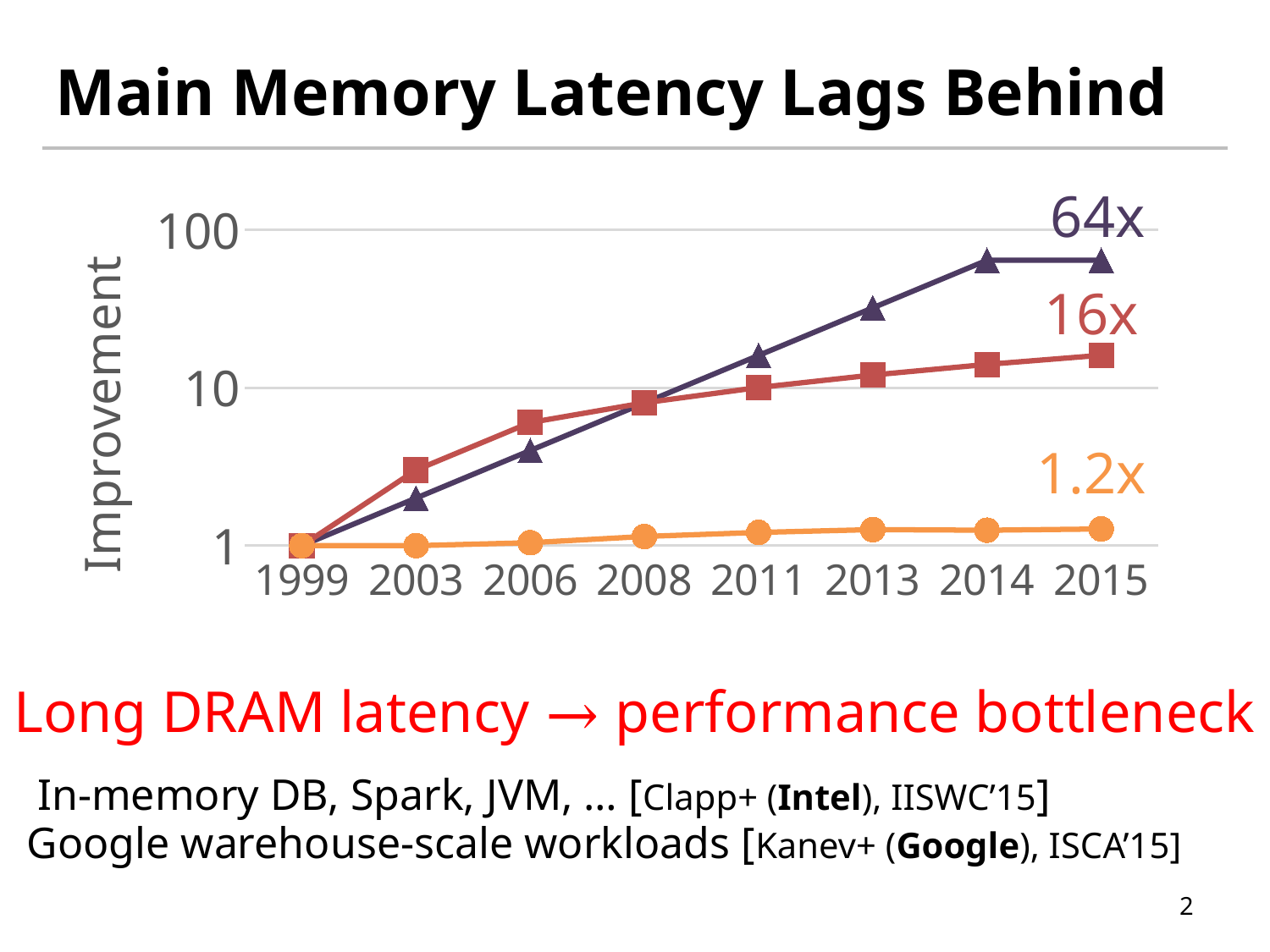
In 2015, which is larger: the improvement of the purple triangle line or the red square line? the purple triangle line What improvement value is labelled at the end of the orange line with circle markers? 1.2x How many years are marked along the x axis of the chart? 8 What is the title of the y axis of the chart? Improvement What kind of chart is shown on the slide? line chart Which line shows the lowest improvement by 2015? the orange line with circle markers (1.2x) Which line reaches the highest improvement by 2015? the purple line with triangle markers (64x) Is the value of the red square line in 2006 greater or less than 10? less What improvement value is labelled at the end of the red line with square markers? 16x What improvement value is labelled at the end of the purple line with triangle markers? 64x Is the value of the purple triangle line in 2013 greater or less than 10? greater How many lines are plotted in the chart? 3